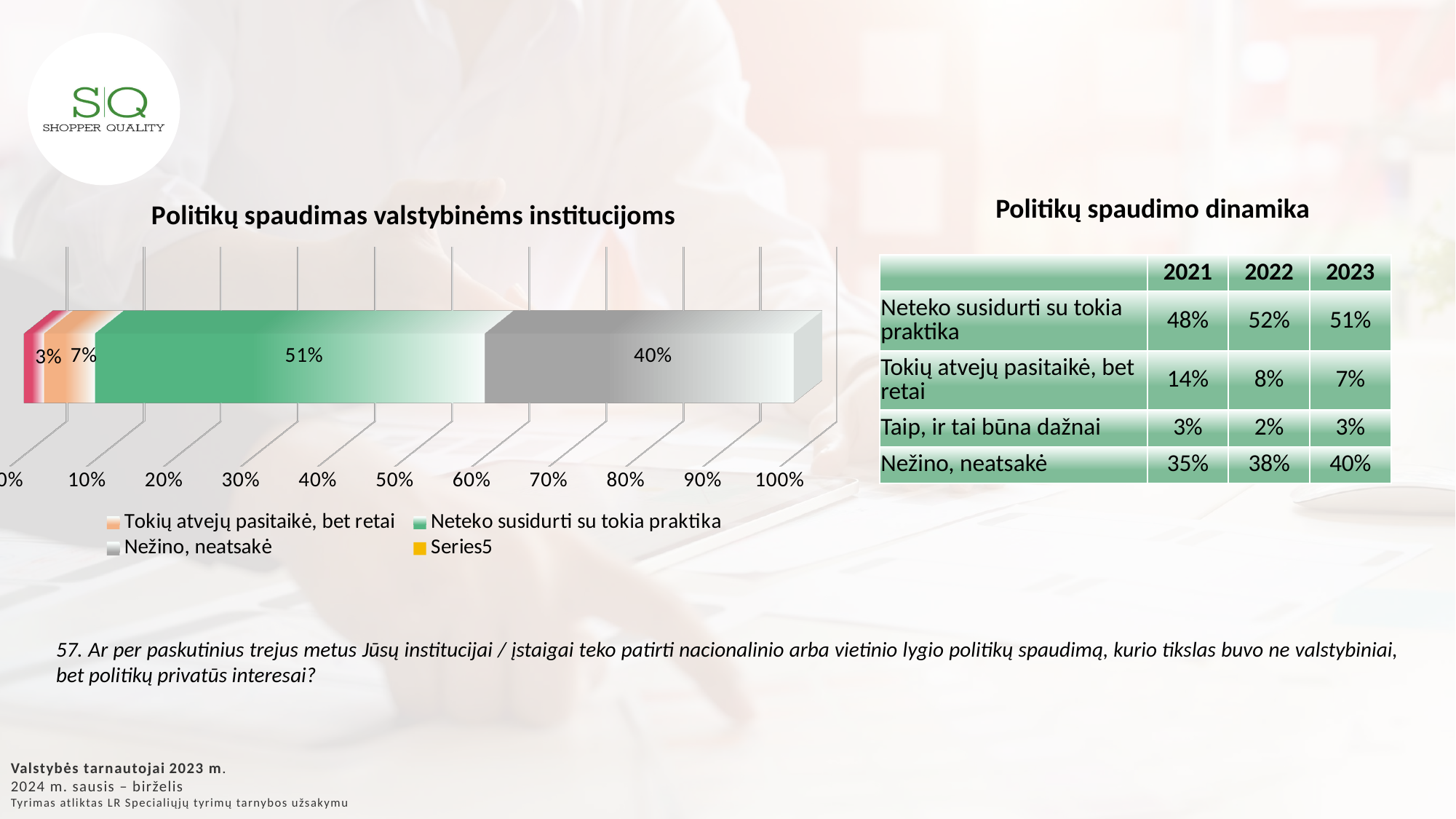
In the chart 'Politikų spaudimas valstybinėms institucijoms', which segment has the largest value? Neteko susidurti su tokia praktika In the chart 'Politikų spaudimas valstybinėms institucijoms', what is the value for 'Tokių atvejų pasitaikė, bet retai'? 7% In the chart 'Politikų spaudimas valstybinėms institucijoms', what is the value for 'Neteko susidurti su tokia praktika'? 51% In the chart 'Politikų spaudimas valstybinėms institucijoms', which is larger: 'Tokių atvejų pasitaikė, bet retai' or 'Nežino, neatsakė'? Nežino, neatsakė What is the highest value shown on the x axis of the chart 'Politikų spaudimas valstybinėms institucijoms'? 100% What kind of chart is 'Politikų spaudimas valstybinėms institucijoms'? Stacked bar chart How many data labels are printed on the bar in the chart 'Politikų spaudimas valstybinėms institucijoms'? 4 In the chart 'Politikų spaudimas valstybinėms institucijoms', is the value for 'Neteko susidurti su tokia praktika' greater or less than 50%? greater How many entries does the legend of the chart 'Politikų spaudimas valstybinėms institucijoms' list? 4 In the chart 'Politikų spaudimas valstybinėms institucijoms', what is the difference between 'Neteko susidurti su tokia praktika' and 'Nežino, neatsakė'? 11% What is the title of the bar chart on the left of the slide? Politikų spaudimas valstybinėms institucijoms In the chart 'Politikų spaudimas valstybinėms institucijoms', what is the value for 'Nežino, neatsakė'? 40%